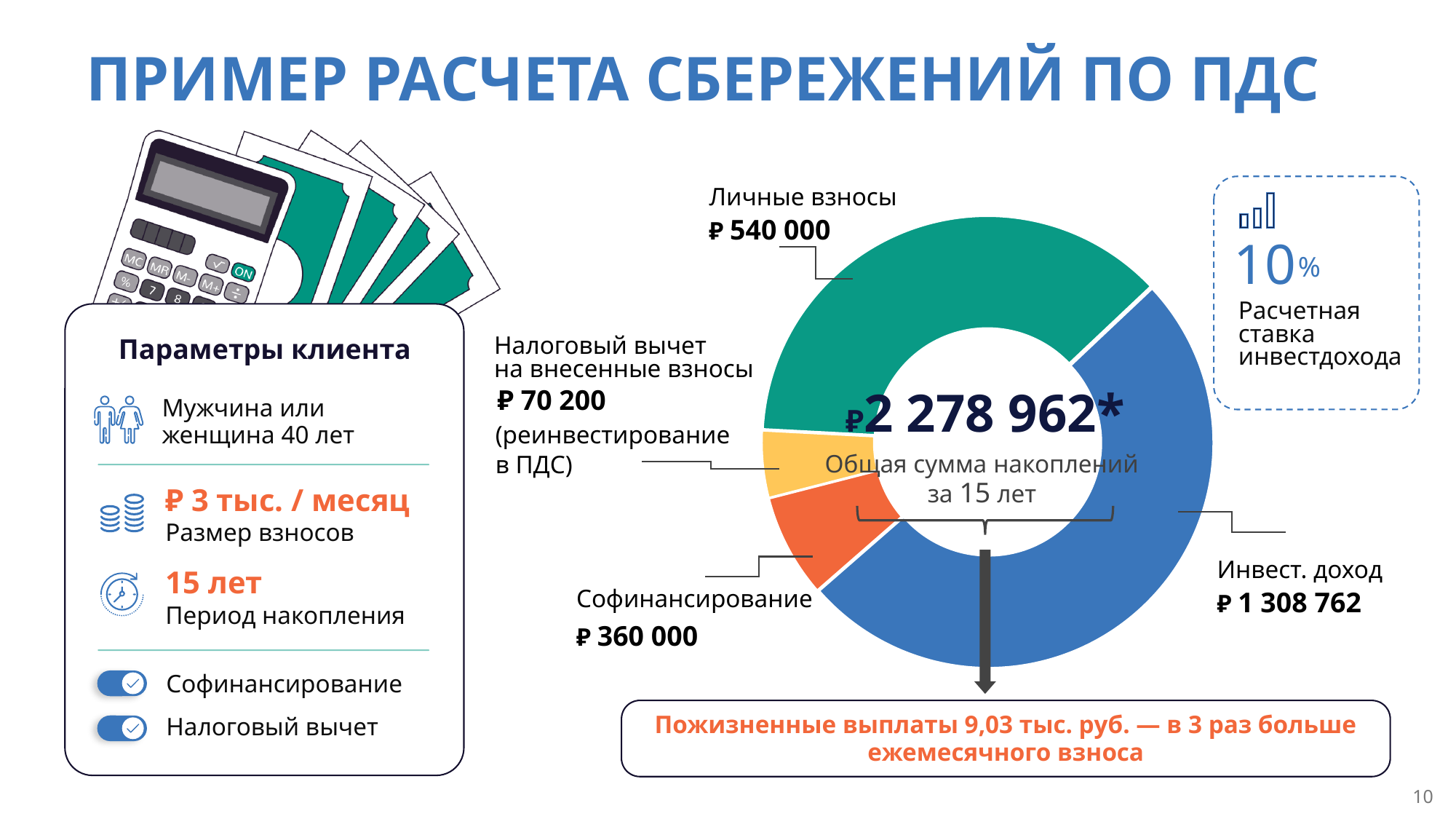
What is the difference between Личные взносы and Софинансирование in the donut chart? ₽ 180 000 What is the value of the Инвест. доход segment in the donut chart? ₽ 1 308 762 Which segment of the donut chart is the smallest? Налоговый вычет на внесенные взносы What total is shown in the centre of the donut chart? ₽2 278 962* What is the value of the Софинансирование segment in the donut chart? ₽ 360 000 What colour is the Инвест. доход segment in the donut chart? blue What kind of chart is shown on the slide? pie (donut) chart How many segments does the donut chart have? 4 Which is larger in the donut chart: Софинансирование or Личные взносы? Личные взносы Which segment of the donut chart is the largest? Инвест. доход What is the value of the Личные взносы segment in the donut chart? ₽ 540 000 What is the value of the Налоговый вычет на внесенные взносы segment in the donut chart? ₽ 70 200